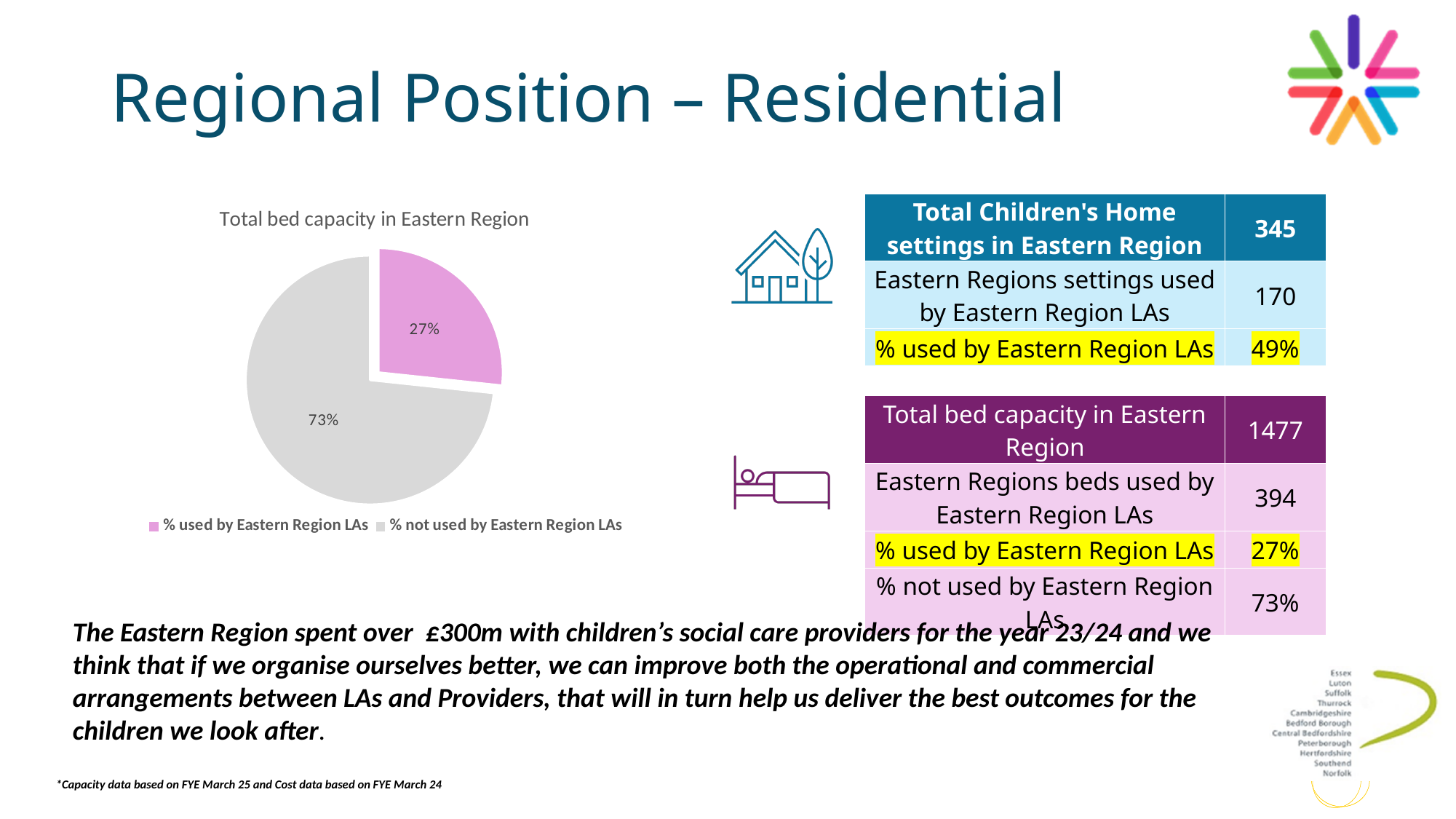
What kind of chart is shown on the slide? pie chart What is the title of the pie chart? Total bed capacity in Eastern Region What share of the pie is labelled '% used by Eastern Region LAs'? 27% What is the difference in percentage points between the '% not used by Eastern Region LAs' slice and the '% used by Eastern Region LAs' slice? 46 Which slice of the pie chart is the smallest? % used by Eastern Region LAs Which slice of the pie chart is the largest? % not used by Eastern Region LAs What colour is the '% used by Eastern Region LAs' slice in the pie chart? pink Which is larger in the pie chart: '% used by Eastern Region LAs' or '% not used by Eastern Region LAs'? % not used by Eastern Region LAs How many entries does the pie chart's legend list? 2 How many slices does the pie chart have? 2 What share of the pie is labelled '% not used by Eastern Region LAs'? 73%